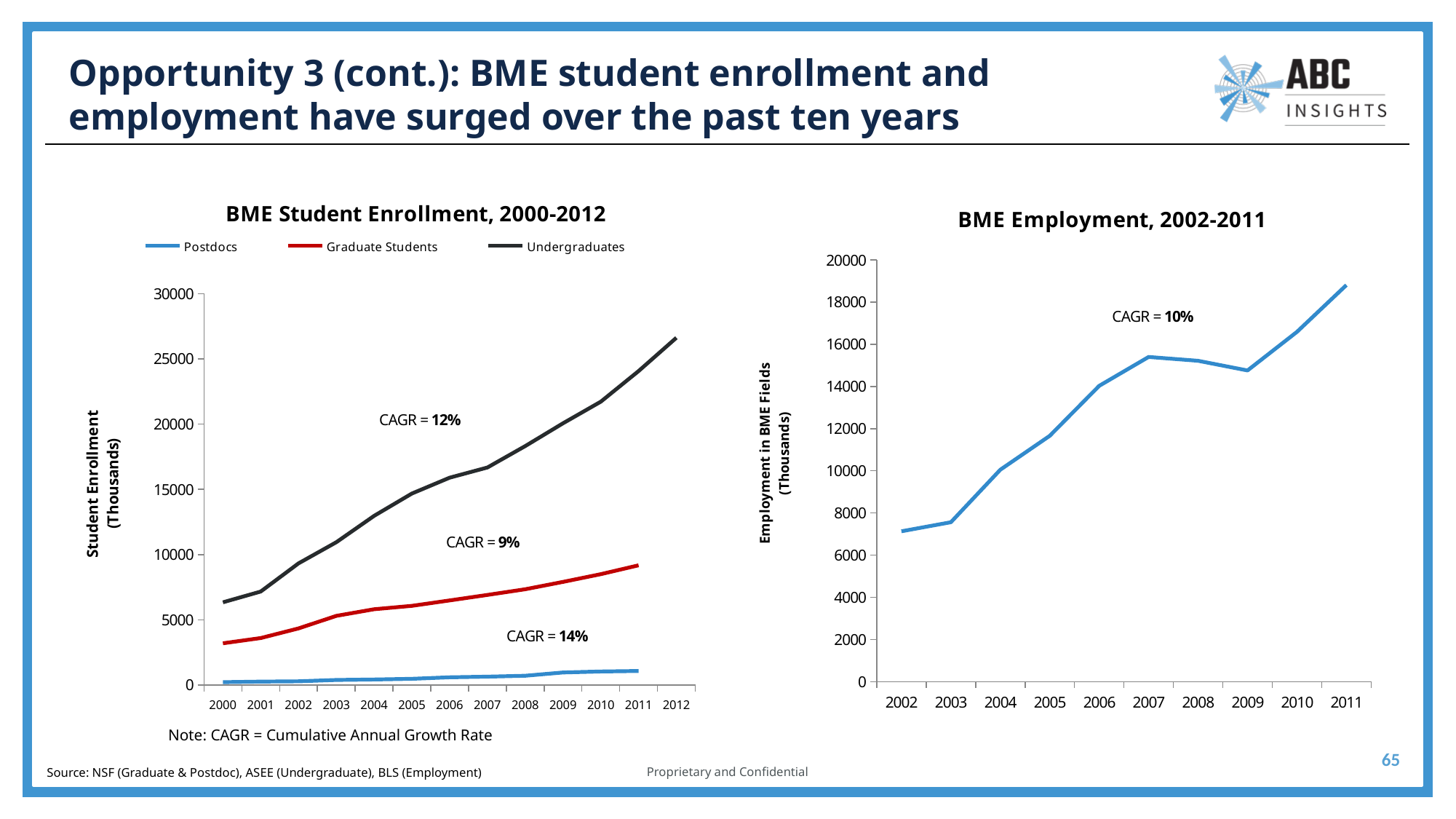
In the BME Student Enrollment, 2000-2012 chart, what CAGR is shown for Graduate Students? 9% In the BME Employment, 2002-2011 chart, what CAGR is shown? 10% In the BME Employment, 2002-2011 chart, is the value for 2002 greater or less than 8000? less In the BME Student Enrollment, 2000-2012 chart, is the Undergraduates value for 2012 greater or less than 25000? greater In the BME Student Enrollment, 2000-2012 chart, which series has the highest enrollment throughout the period? Undergraduates In the BME Student Enrollment, 2000-2012 chart, is the Graduate Students value for 2011 greater or less than 10000? less How many series does the legend of the BME Student Enrollment, 2000-2012 chart list? 3 In the BME Student Enrollment, 2000-2012 chart, what CAGR is shown for Postdocs? 14% In the BME Student Enrollment, 2000-2012 chart, what CAGR is shown for Undergraduates? 12% What kind of chart is the BME Student Enrollment, 2000-2012 chart? line chart How many years are shown on the x axis of the BME Employment, 2002-2011 chart? 10